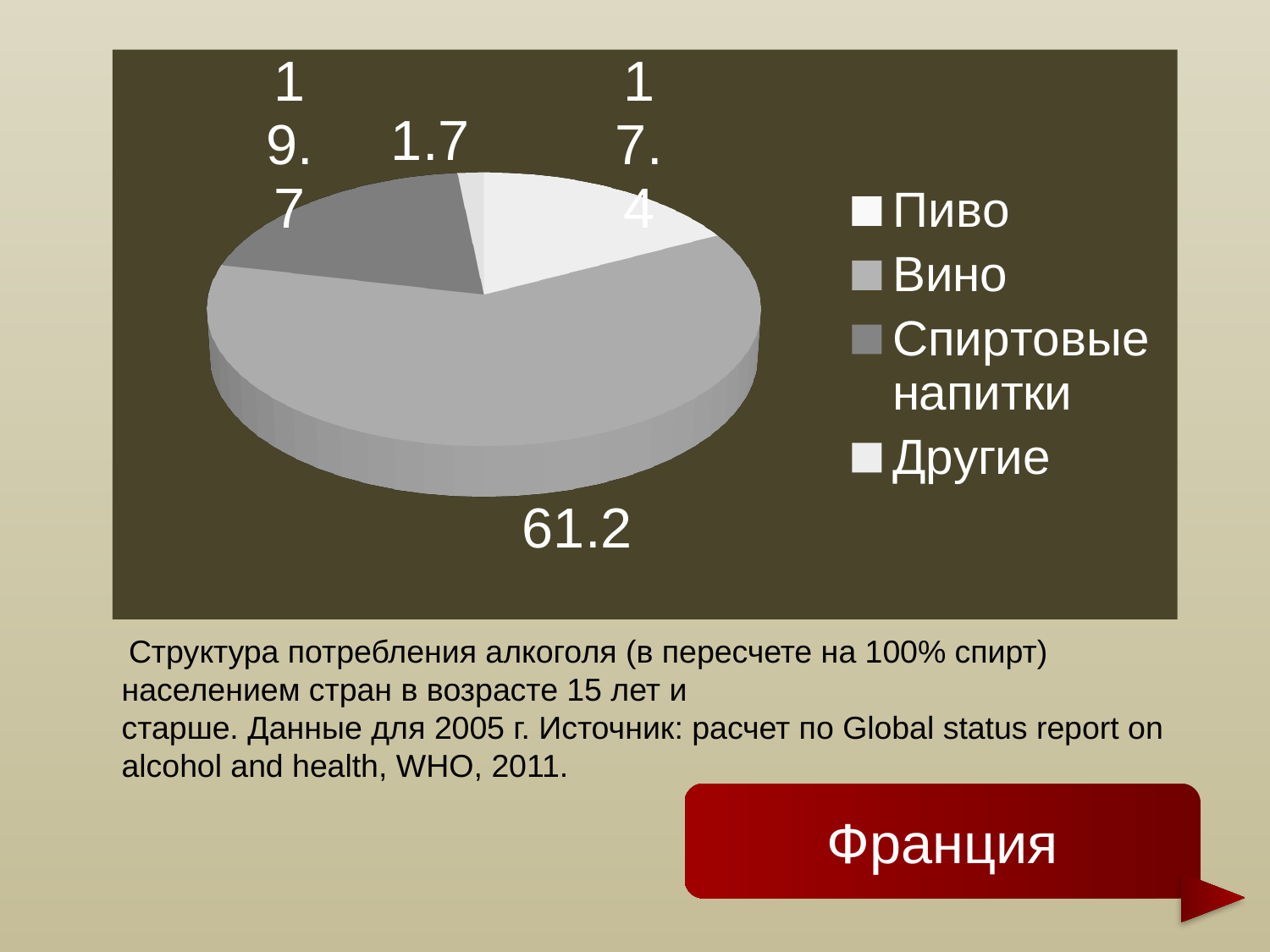
How many slices does the pie chart have? 4 Which category has the smallest slice in the pie chart? Другие What is the difference between the values for Вино and Спиртовые напитки? 41.5 Which category has the largest slice in the pie chart? Вино How many entries does the legend of the pie chart list? 4 What kind of chart is shown on the slide? pie chart Which is larger in the pie chart, Пиво or Спиртовые напитки? Спиртовые напитки What is the value shown for Пиво in the pie chart? 17.4 What is the value shown for Спиртовые напитки in the pie chart? 19.7 What is the value shown for Вино in the pie chart? 61.2 What is the value shown for Другие in the pie chart? 1.7 Which country is named in the red box on the slide? Франция